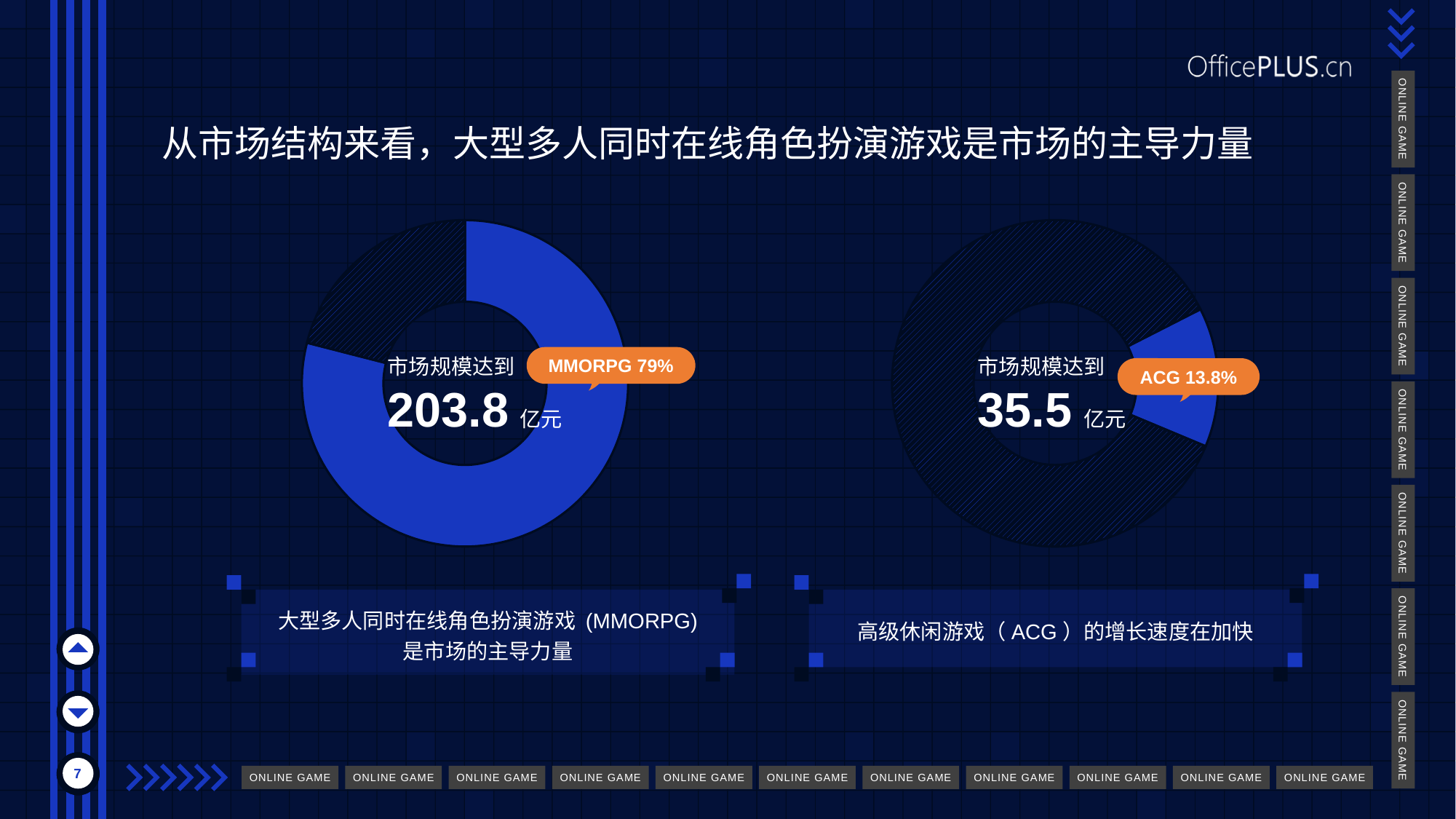
Which has the larger market share, MMORPG in the left chart or ACG in the right chart? MMORPG What is the difference in market size between MMORPG (left chart) and ACG (right chart)? 168.3 亿元 In the left donut chart, what market size (市场规模) is shown for MMORPG? 203.8 亿元 How many donut charts are shown on the slide? 2 Is the ACG share in the right chart greater or less than 25%? less In the left donut chart, what share of the market does MMORPG hold? 79% In the right donut chart, what market size (市场规模) is shown for ACG? 35.5 亿元 In the right donut chart, what share of the market does ACG hold? 13.8% What kind of chart is used on the left side of the slide? Donut (pie) chart What is the difference in percentage points between the MMORPG share (left chart) and the ACG share (right chart)? 65.2% Is the MMORPG share in the left chart greater or less than 50%? greater What colour is the label bubble showing 'MMORPG 79%' on the left chart? Orange